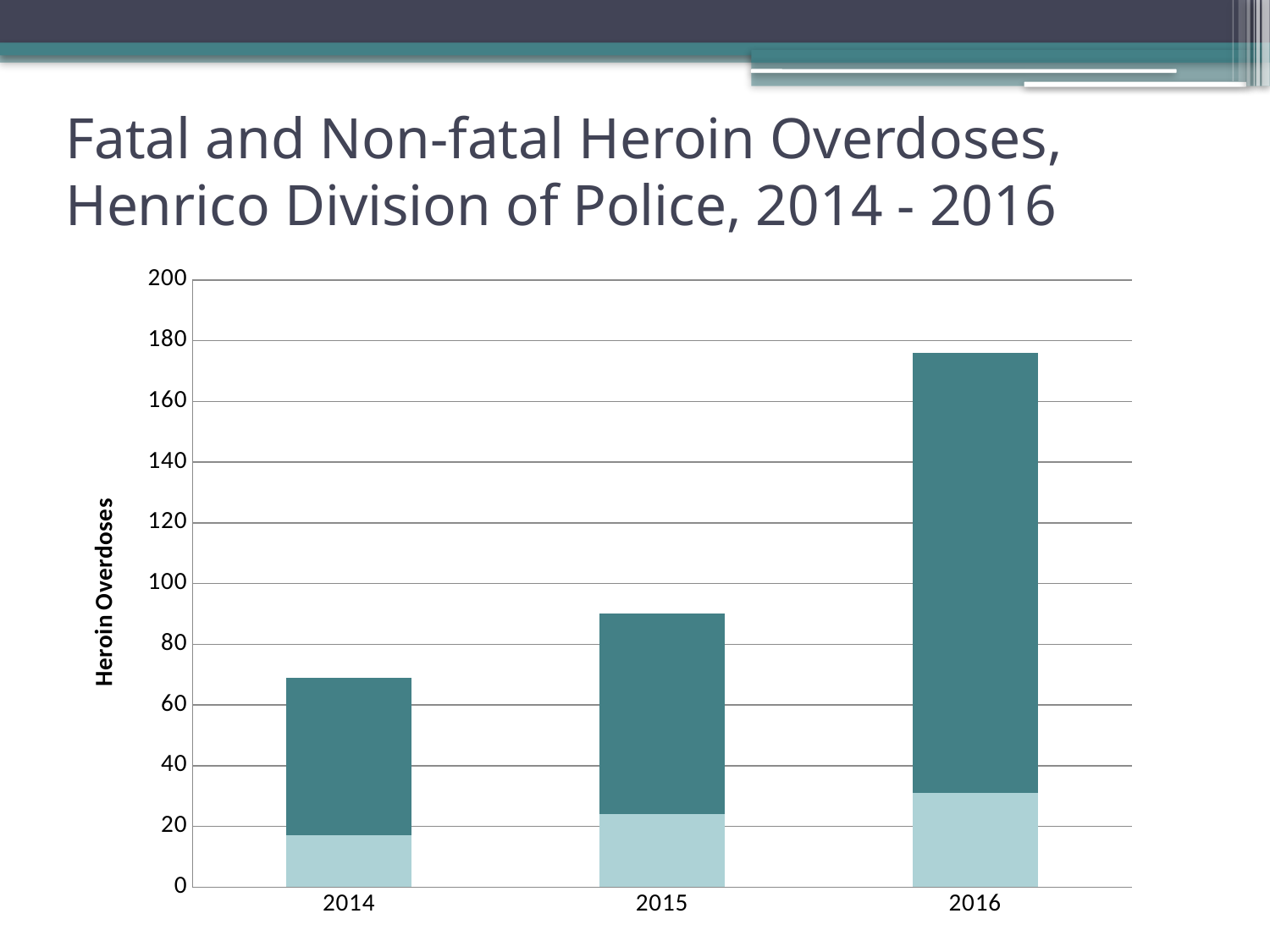
Is the total bar for 2015 greater or less than 100? less Which year has a taller total bar, 2014 or 2015? 2015 Do the total heroin overdoses rise or fall from 2014 to 2016? Rise What is the title of the slide containing the chart? Fatal and Non-fatal Heroin Overdoses, Henrico Division of Police, 2014 - 2016 Is the total bar for 2016 greater or less than 160? greater Is the total bar for 2015 greater or less than 80? greater Which year has the tallest bar in the chart? 2016 What is the label on the vertical axis of the chart? Heroin Overdoses What kind of chart is shown on the slide? Stacked bar chart How many years are shown on the x axis of the chart? 3 Which year has the shortest bar in the chart? 2014